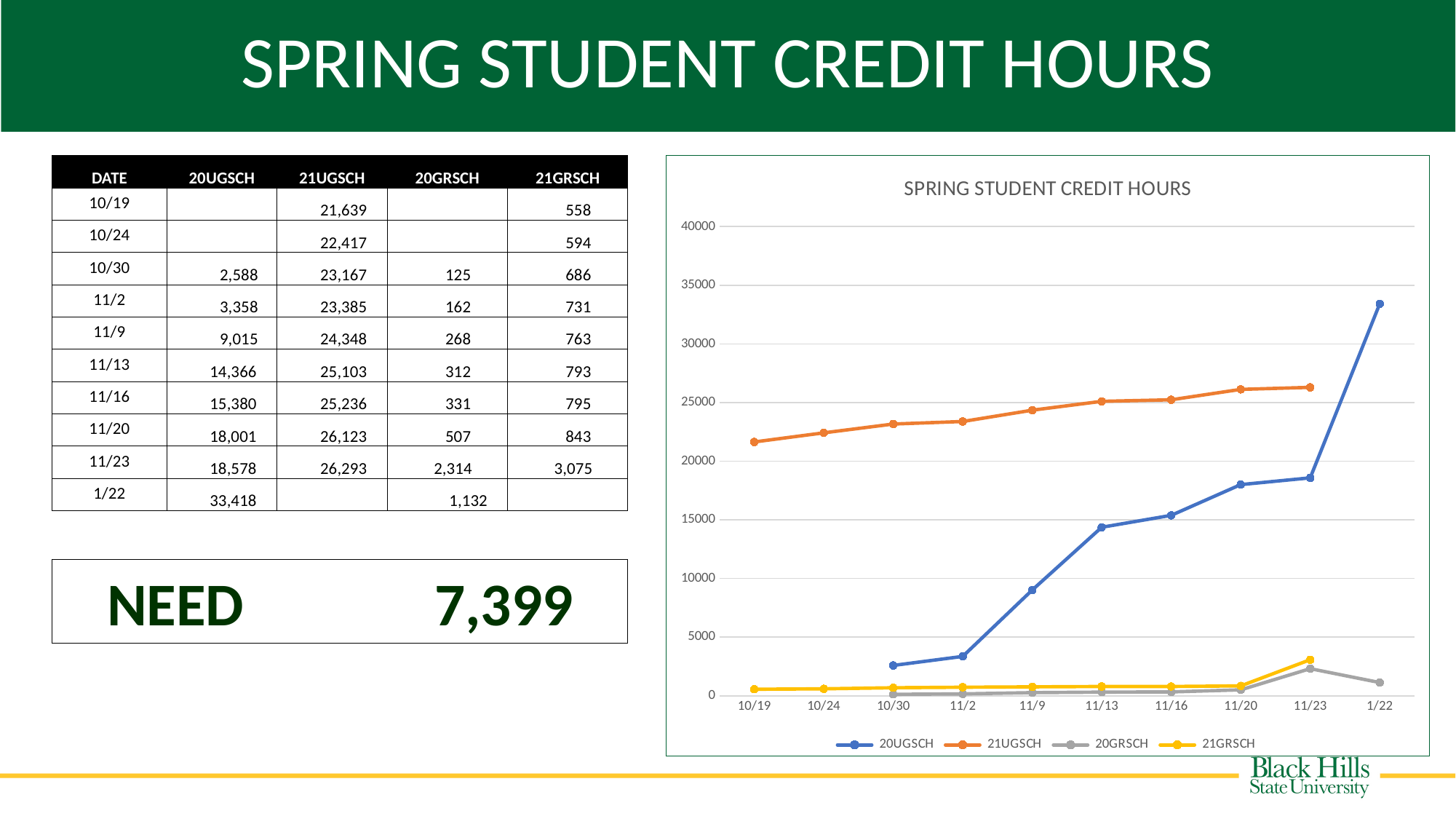
On 11/20, which is larger: 20UGSCH or 21UGSCH? 21UGSCH Is the 21UGSCH value on 11/2 greater or less than 25000? less Which series has the highest value on 11/23? 21UGSCH What is the 21UGSCH value on 10/19? 21,639 Does the 21UGSCH line rise or fall from 10/19 to 11/23? rise Is the 20UGSCH value on 1/22 greater or less than 30000? greater What is the 20UGSCH value on 1/22? 33,418 What is the title of the chart? SPRING STUDENT CREDIT HOURS What is the difference between 21UGSCH and 20UGSCH on 11/23? 7,715 How many dates are shown along the x axis of the chart? 10 What kind of chart is shown on the slide? line chart How many series does the chart's legend list? 4